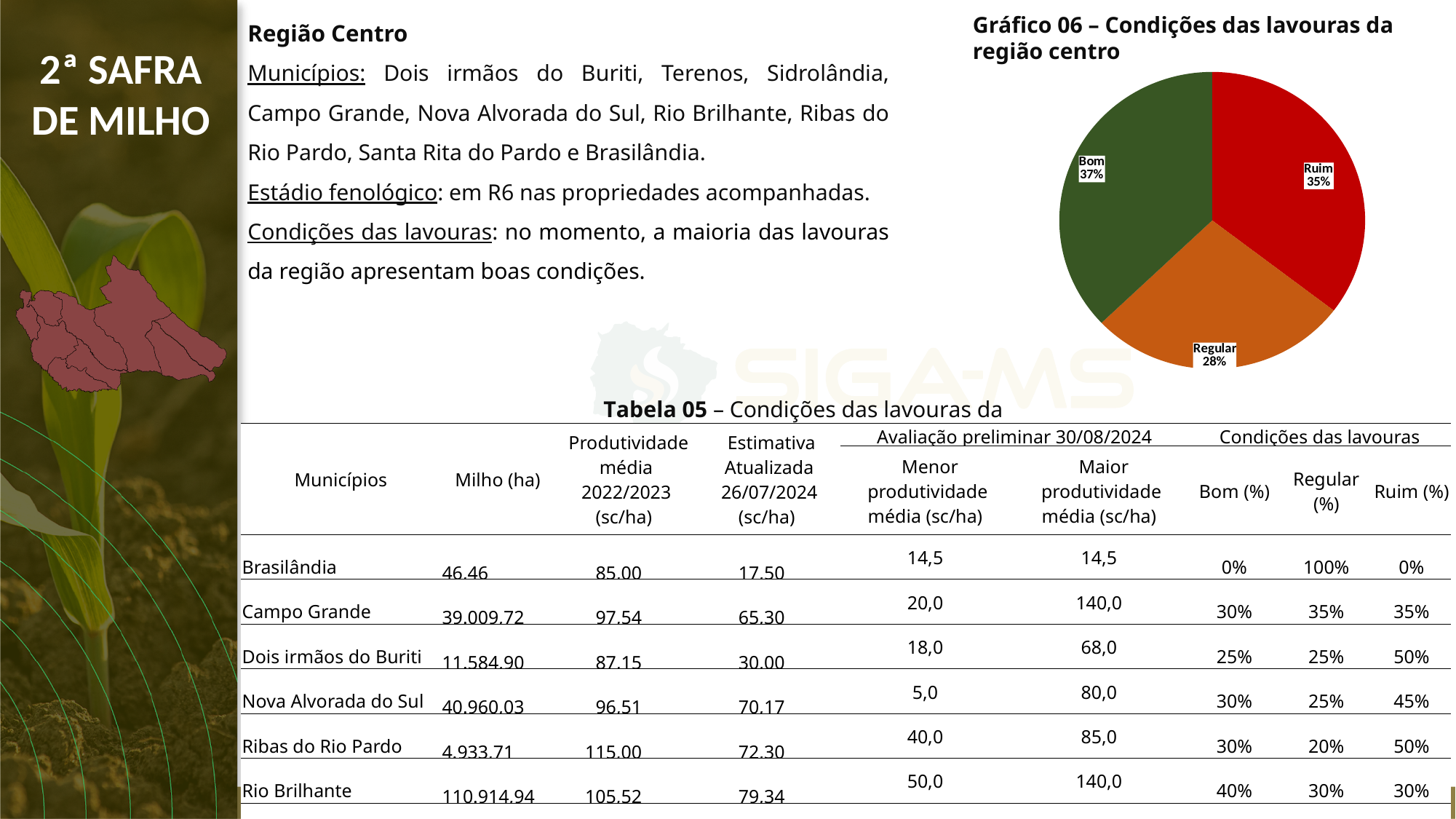
In Gráfico 06, which condition category has the largest share? Bom What type of chart is Gráfico 06? pie chart In Gráfico 06, what share of the lavouras is rated Ruim? 35% In Gráfico 06, what is the difference in percentage points between the Ruim and Regular shares? 7 In Gráfico 06, what share of the lavouras is rated Bom? 37% In Gráfico 06, which condition category has the smallest share? Regular In Gráfico 06, what is the difference in percentage points between the Bom and Regular shares? 9 In Gráfico 06, how many slices does the pie chart have? 3 In Gráfico 06, which is larger, the Bom share or the Ruim share? Bom What is the title of the pie chart on the slide? Gráfico 06 – Condições das lavouras da região centro In Gráfico 06, what share of the lavouras is rated Regular? 28% In Gráfico 06, what colour is the Ruim slice? red